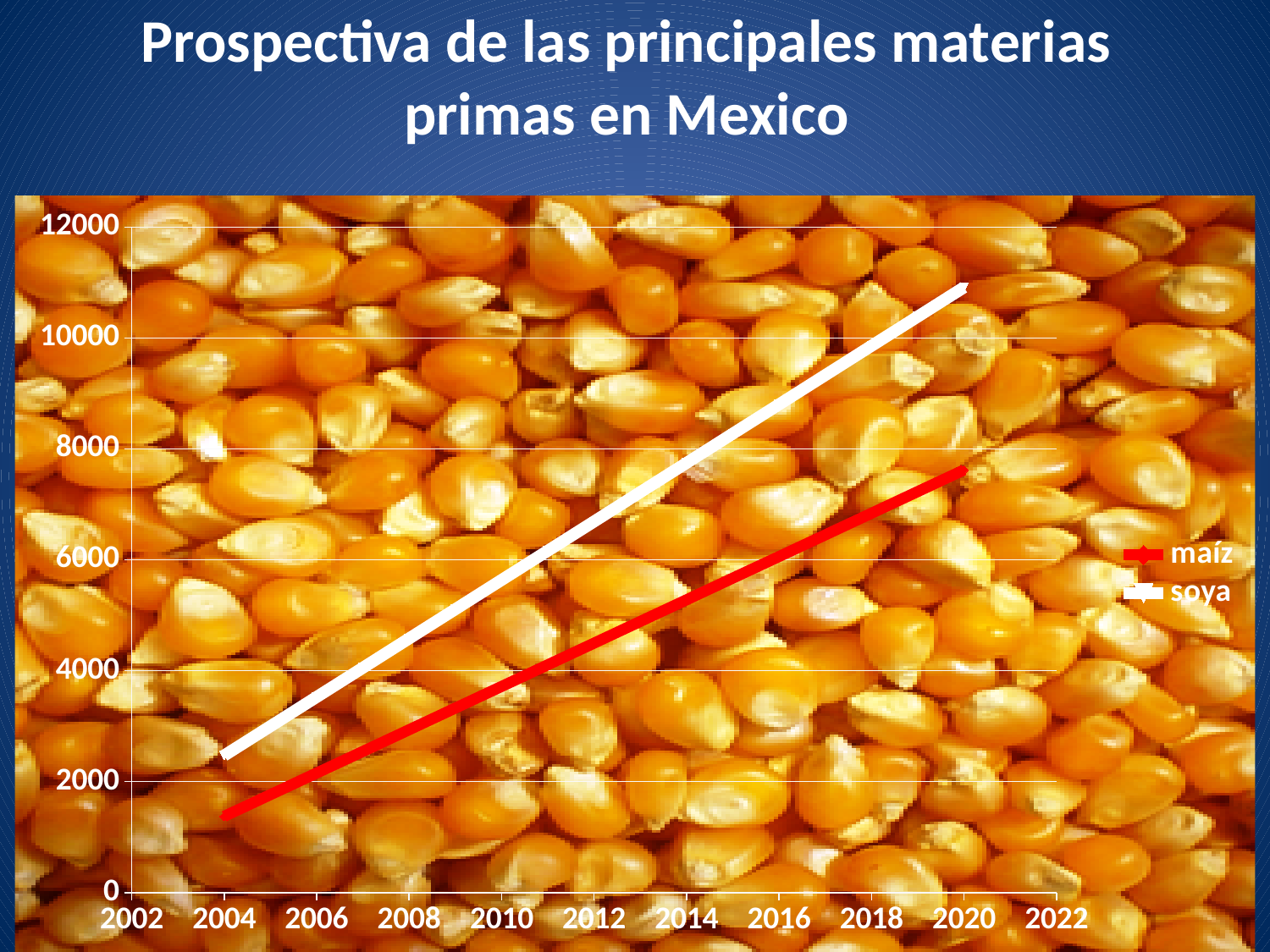
Is the value for soya in 2020 greater or less than 10000? greater Which series has the higher value in 2020, maíz or soya? soya Does the value for maíz rise or fall from 2004 to 2020? rise What kind of chart is shown on the slide? line chart How many series does the legend list? 2 Is the value for soya in 2004 greater or less than 2000? greater Is the value for maíz in 2020 greater or less than 6000? greater Which series has the higher value in 2004, maíz or soya? soya Which series is plotted with the red line? maíz Does the value for soya rise or fall from 2004 to 2020? rise What is the title of the slide containing the chart? Prospectiva de las principales materias primas en Mexico